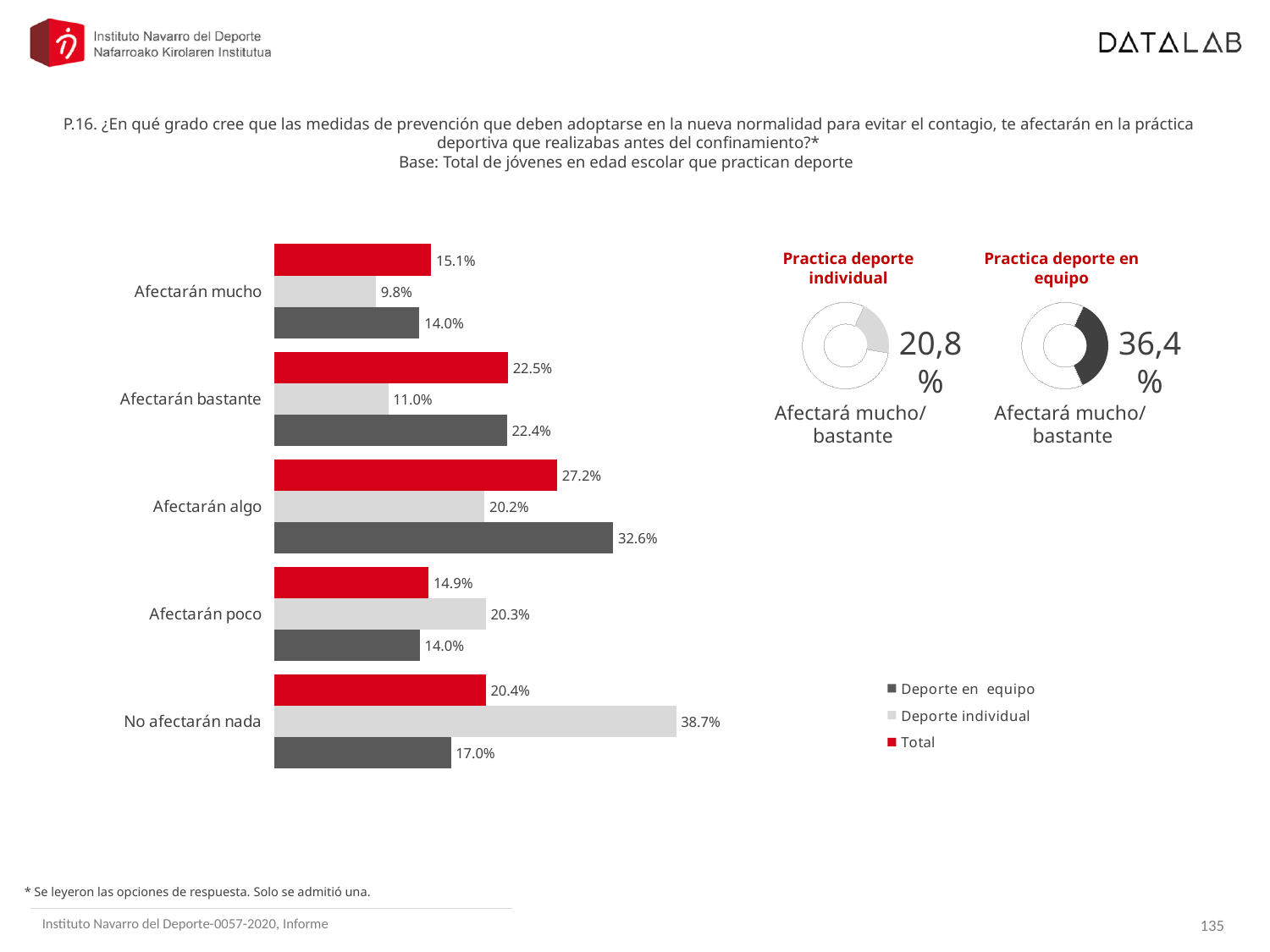
In the bar chart, for "Afectarán poco", which is larger: the "Deporte individual" value or the Total value? Deporte individual In the bar chart, which category has the lowest "Deporte individual" value? Afectarán mucho In the bar chart, what is the difference between the "Deporte individual" and "Deporte en equipo" values for "No afectarán nada"? 21.7% How many categories does the bar chart show? 5 Which donut chart shows the larger value for "Afectará mucho/bastante": "Practica deporte individual" or "Practica deporte en equipo"? Practica deporte en equipo What kind of chart is the chart on the left of the slide? Bar chart In the bar chart, which category has the highest "Deporte en equipo" value? Afectarán algo How many series does the bar chart's legend list? 3 In the bar chart, what is the Total value for "Afectarán algo"? 27.2% In the donut chart titled "Practica deporte en equipo", what percentage is shown for "Afectará mucho/bastante"? 36,4% In the bar chart, what is the "Deporte individual" value for "No afectarán nada"? 38.7% In the bar chart, what is the "Deporte en equipo" value for "Afectarán bastante"? 22.4%